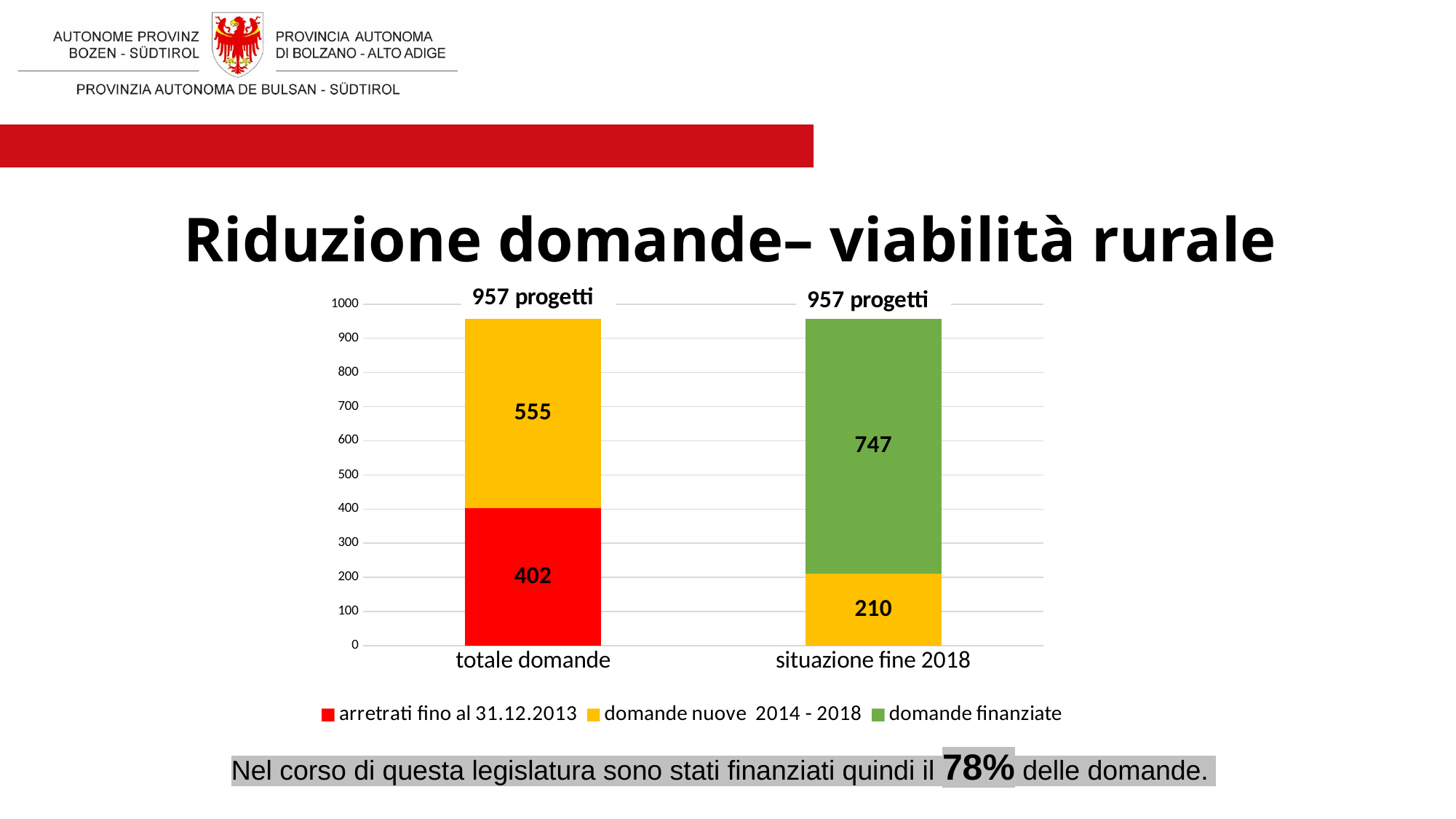
What is the value of 'domande nuove 2014 - 2018' in the 'situazione fine 2018' bar? 210 What is the value of 'domande finanziate' in the 'situazione fine 2018' bar? 747 How many series does the legend list? 3 What is the total of the 'totale domande' stacked bar? 957 Is the value of 'domande finanziate' greater or less than 700? greater What is the value of 'arretrati fino al 31.12.2013' in the 'totale domande' bar? 402 What type of chart is shown on the slide? Stacked bar chart Which is larger in the 'totale domande' bar: 'arretrati fino al 31.12.2013' or 'domande nuove 2014 - 2018'? domande nuove 2014 - 2018 How many categories are shown on the x axis? 2 What colour represents 'domande finanziate' in the chart? Green What is the value of 'domande nuove 2014 - 2018' in the 'totale domande' bar? 555 What is the difference between 'domande finanziate' (747) and 'domande nuove 2014 - 2018' (210) in the 'situazione fine 2018' bar? 537